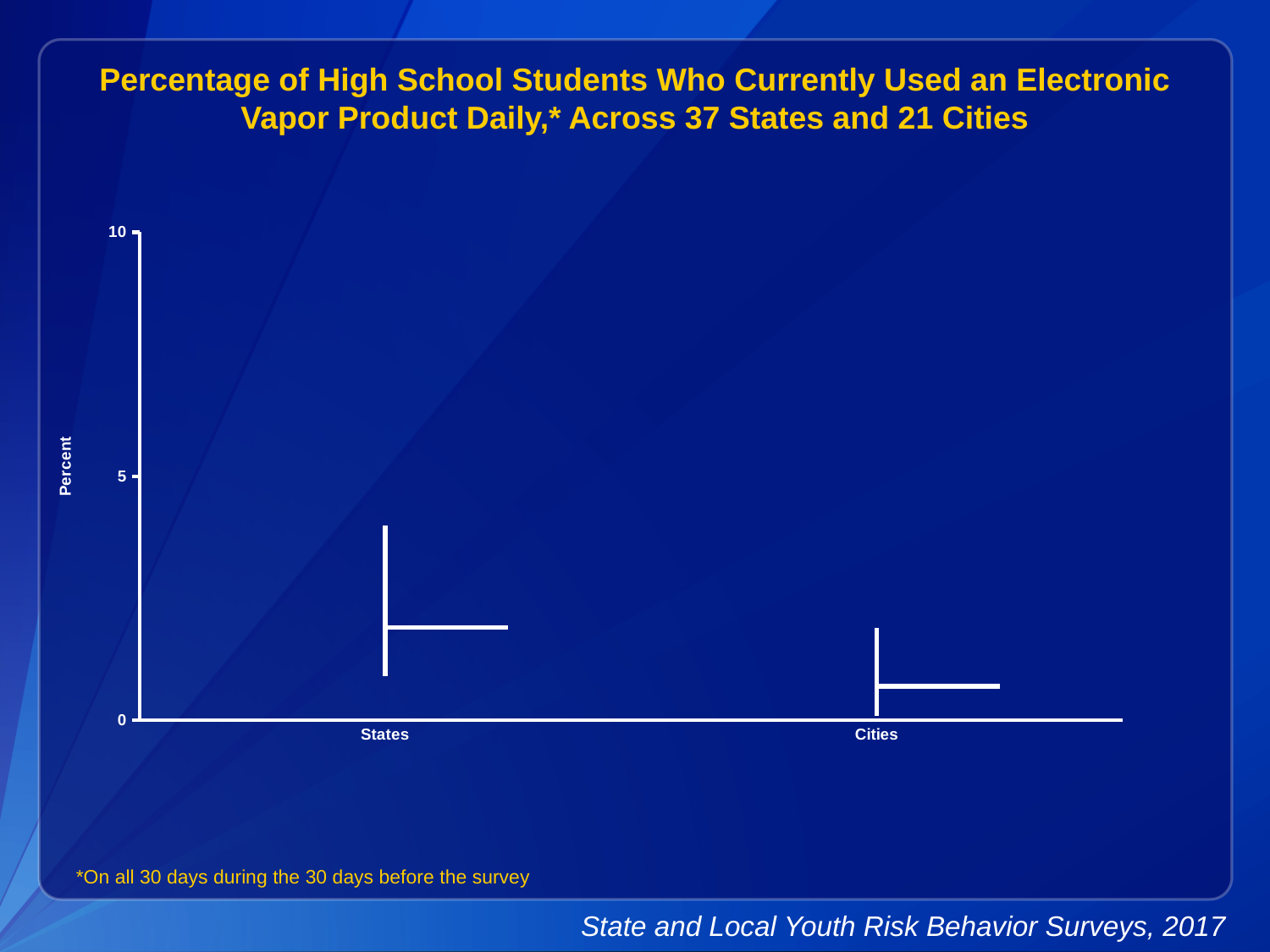
How many categories are shown on the x axis of the chart? 2 Which category has the lowest median value in the chart? Cities Is the top of the range for Cities greater or less than 5? less Is the top of the range for States greater or less than 5? less Which category has the highest median value in the chart? States What is the label on the y axis of the chart? Percent What is the highest value shown on the y axis of the chart? 10 Is the median value for Cities greater or less than 5? less Which category has the higher median value, States or Cities? States